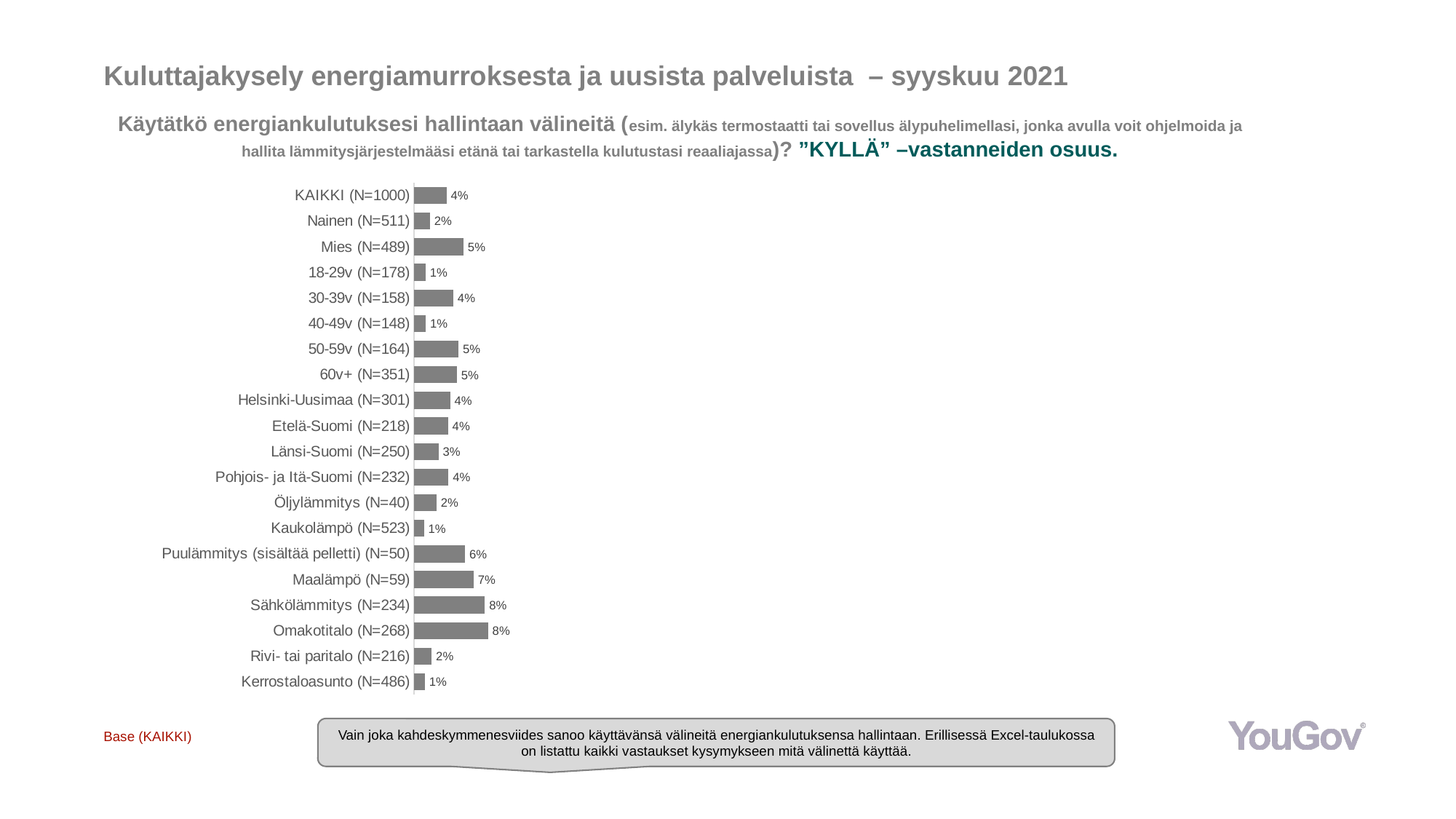
What is the highest value shown on the chart? 8% How many categories (bars) does the chart show? 20 Among the heating types (Öljylämmitys, Kaukolämpö, Puulämmitys, Maalämpö, Sähkölämmitys), which has the highest value? Sähkölämmitys (N=234) What kind of chart is shown on the slide? bar chart What is the value for Nainen (N=511)? 2% Which is larger, the value for Maalämpö (N=59) or the value for Puulämmitys (sisältää pelletti) (N=50)? Maalämpö (N=59) Among the regions (Helsinki-Uusimaa, Etelä-Suomi, Länsi-Suomi, Pohjois- ja Itä-Suomi), which has the lowest value? Länsi-Suomi (N=250) What is the value for Maalämpö (N=59)? 7% What is the value for Kerrostaloasunto (N=486)? 1% What is the value for Länsi-Suomi (N=250)? 3% What is the value for KAIKKI (N=1000)? 4% What is the difference in percentage points between Mies (N=489) and Nainen (N=511)? 3 percentage points